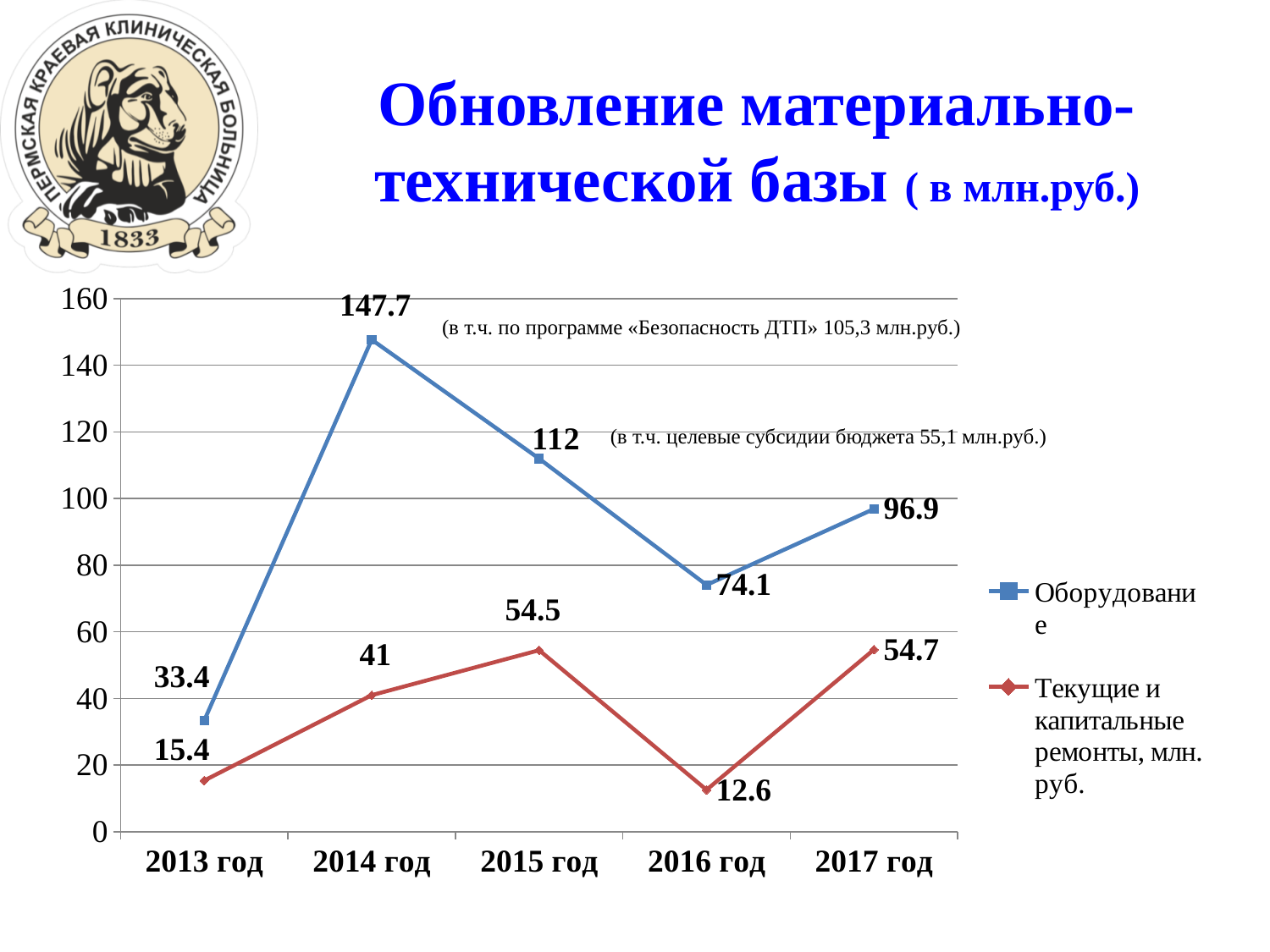
What type of chart is shown on the slide? line chart In which year is the value for Текущие и капитальные ремонты lowest? 2016 год How many series does the legend list? 2 How many years are shown on the x axis? 5 What is the value for Оборудование in 2017 год? 96.9 In which year is the value for Оборудование highest? 2014 год What is the value for Оборудование in 2014 год? 147.7 Which is larger: Оборудование in 2016 год or Текущие и капитальные ремонты in 2015 год? Оборудование in 2016 год Does the Оборудование series rise or fall from 2015 год to 2016 год? fall What is the difference between the Текущие и капитальные ремонты values for 2017 год and 2013 год? 39.3 What is the difference between the Оборудование values for 2014 год and 2015 год? 35.7 What is the value for Текущие и капитальные ремонты in 2016 год? 12.6